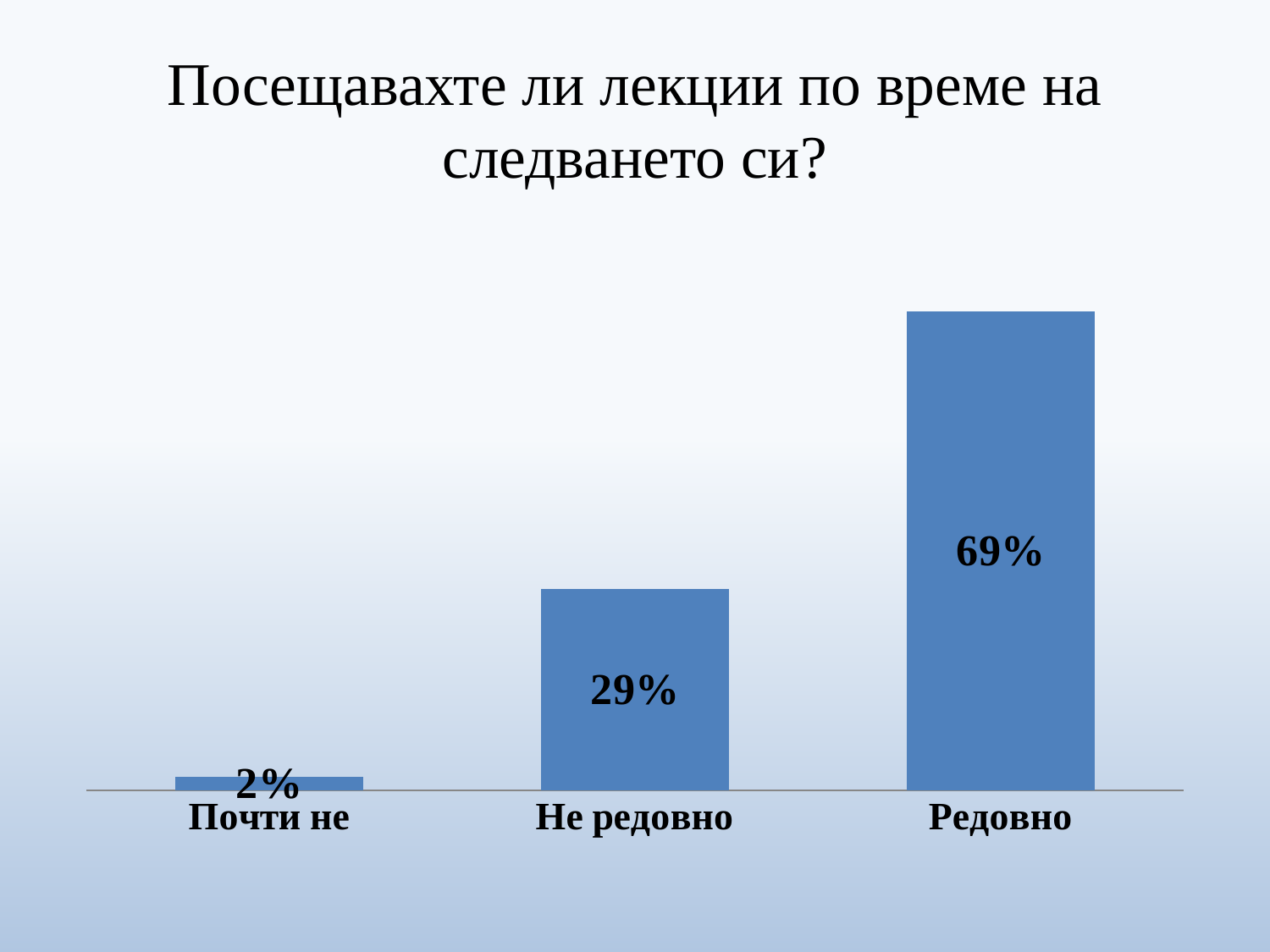
What is the value for "Не редовно"? 29% What is the difference between the values for "Редовно" and "Не редовно"? 40% What is the title of the slide? Посещавахте ли лекции по време на следването си? What is the value for "Почти не"? 2% What is the value for "Редовно"? 69% Which category has the lowest value? Почти не Which category has the highest value? Редовно What kind of chart is shown on the slide? Bar chart Which is larger, the value for "Не редовно" or the value for "Почти не"? Не редовно Do the values rise or fall from left to right along the x axis? Rise How many categories are shown in the chart? 3 What is the difference between the values for "Не редовно" and "Почти не"? 27%